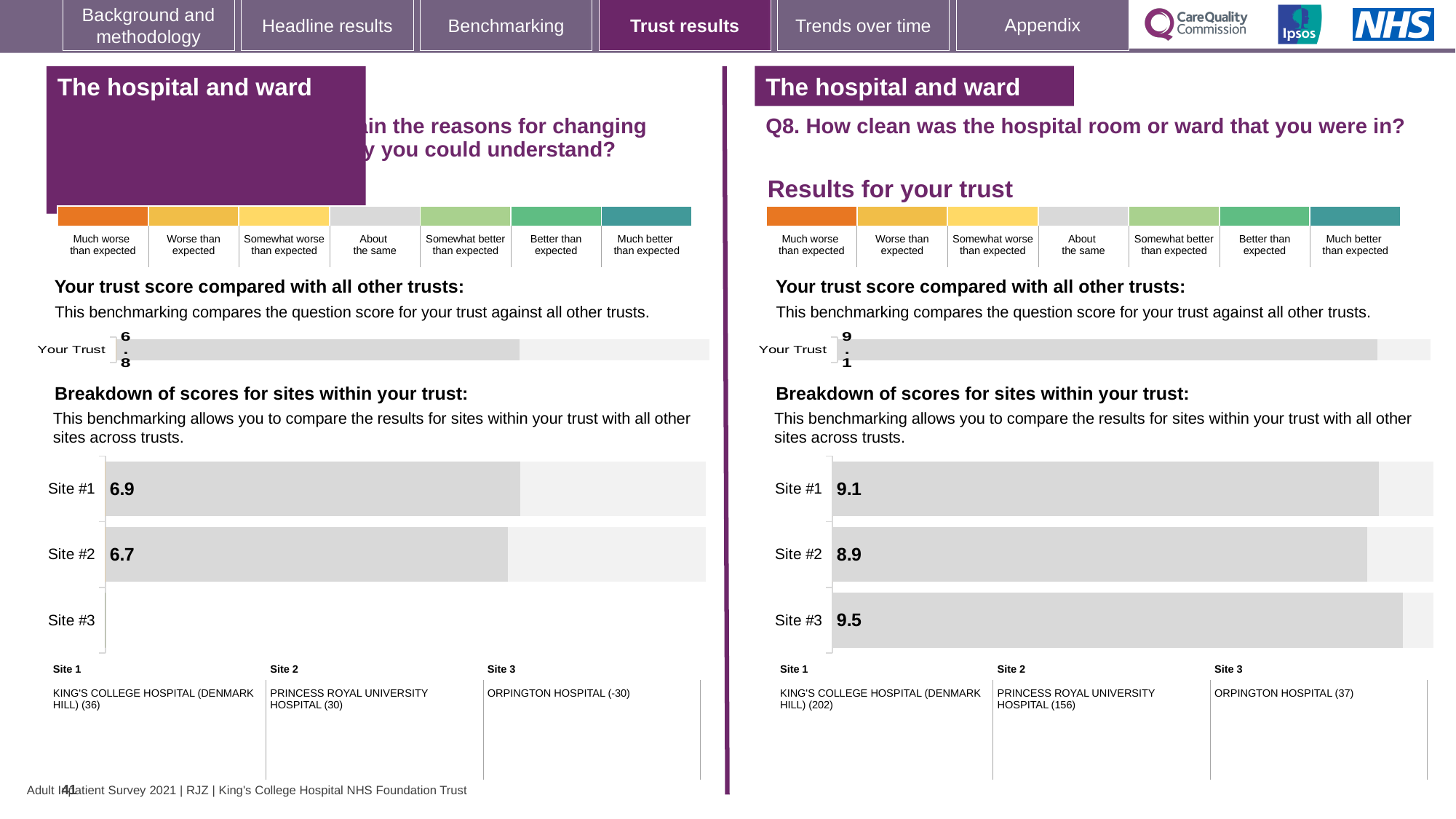
How many sites are listed in the site breakdown chart on the right-hand side for Q8? 3 On the right-hand chart for Q8, which site has the lowest score? Site #2 On the right-hand chart for Q8 (how clean was the hospital room or ward), what is the score for Site #1? 9.1 On the left-hand site breakdown chart, which is larger, the score for Site #1 or Site #2? Site #1 On the left-hand site breakdown chart, what is the score for Site #2? 6.7 On the right-hand chart for Q8, which site has the highest score? Site #3 On the right-hand chart for Q8, what is the 'Your Trust' score? 9.1 On the left-hand chart, what is the 'Your Trust' score? 6.8 On the right-hand chart for Q8, what is the difference between the scores for Site #3 and Site #2? 0.6 On the right-hand chart for Q8, what is the score for Site #3? 9.5 On the left-hand site breakdown chart, what is the score for Site #1? 6.9 What kind of chart is used to show the breakdown of scores for sites within the trust? Bar chart